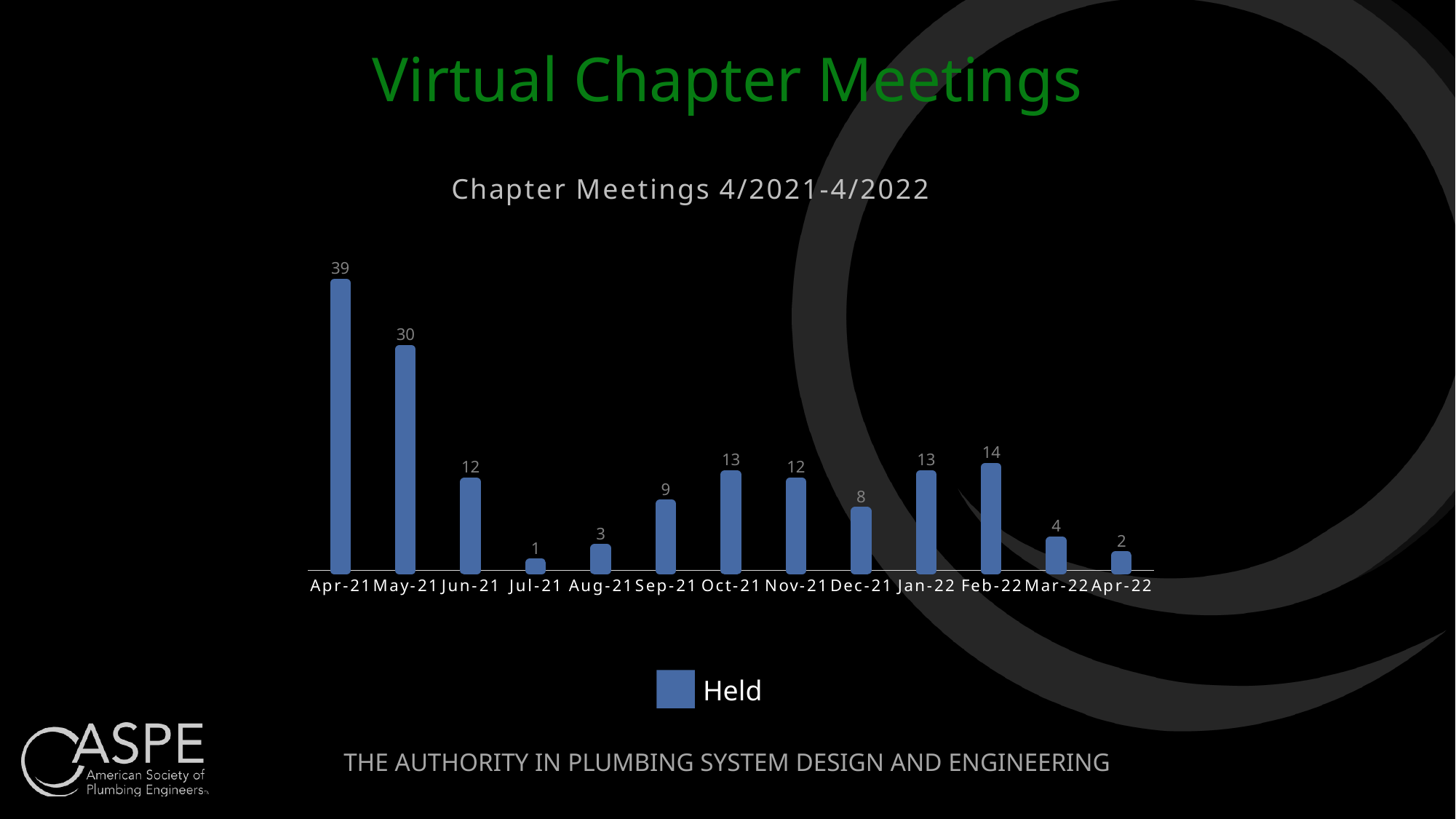
Which month has the highest number of meetings held? Apr-21 What is the name of the series in the legend? Held How many series does the legend list? 1 Which is larger, the value for Oct-21 or the value for Dec-21? Oct-21 How many months are shown on the x axis? 13 What is the value for Feb-22? 14 What is the difference between the values for Apr-21 and May-21? 9 What kind of chart is shown? Bar chart Which month has the lowest number of meetings held? Jul-21 What is the title of the chart? Chapter Meetings 4/2021-4/2022 How many chapter meetings were held in Apr-21? 39 What is the value for Jul-21? 1